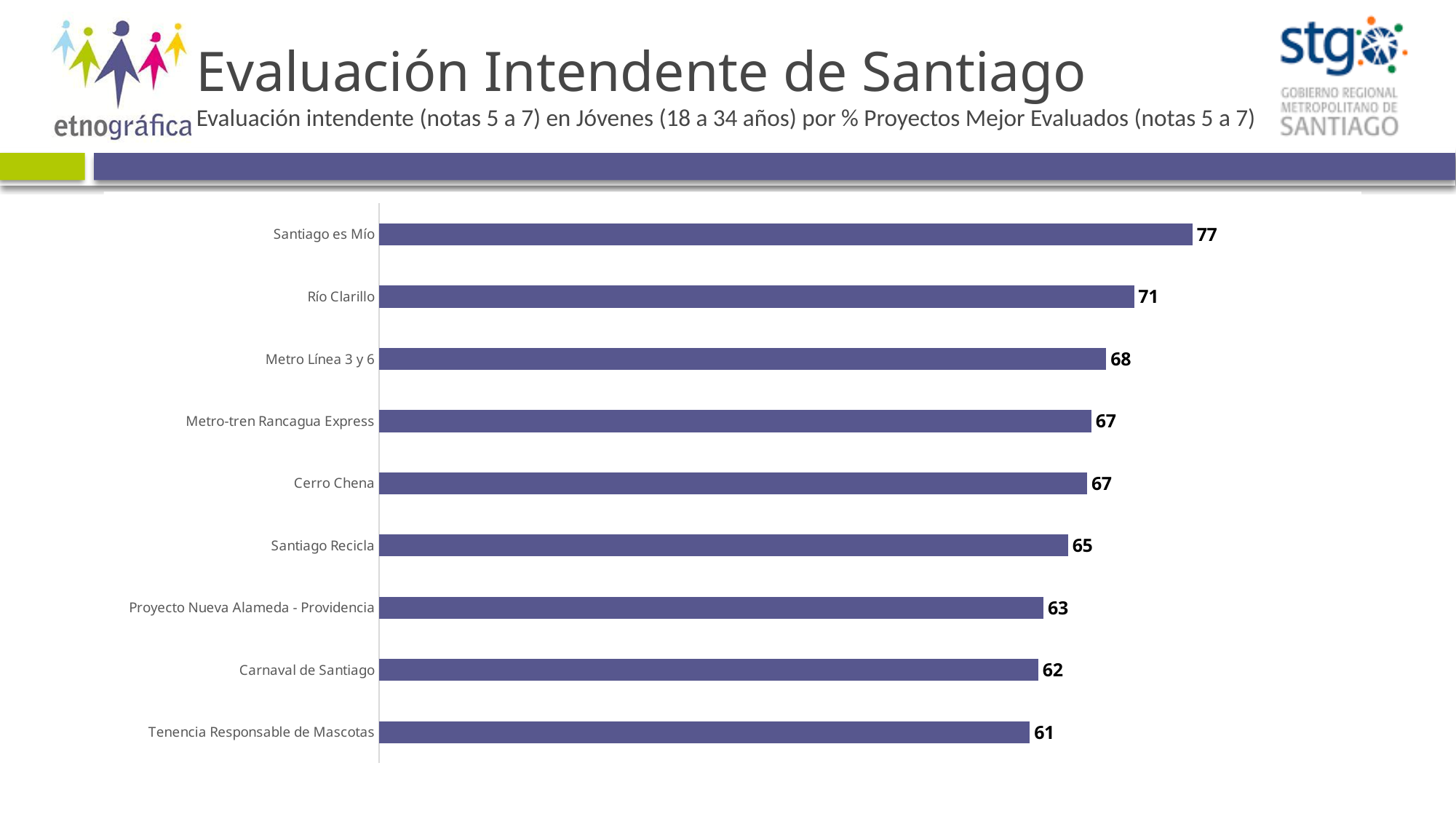
What is the value for Santiago es Mío? 77 Which category has the highest value? Santiago es Mío What kind of chart is shown on the slide? Bar chart Which category has the lowest value? Tenencia Responsable de Mascotas Which two categories share the value 67? Metro-tren Rancagua Express and Cerro Chena Which has a larger value, Carnaval de Santiago or Proyecto Nueva Alameda - Providencia? Proyecto Nueva Alameda - Providencia What is the value for Santiago Recicla? 65 What is the value for Río Clarillo? 71 How many categories are shown in the chart? 9 What is the difference between the values for Santiago es Mío and Tenencia Responsable de Mascotas? 16 What is the value for Tenencia Responsable de Mascotas? 61 What is the difference between the values for Río Clarillo and Metro Línea 3 y 6? 3